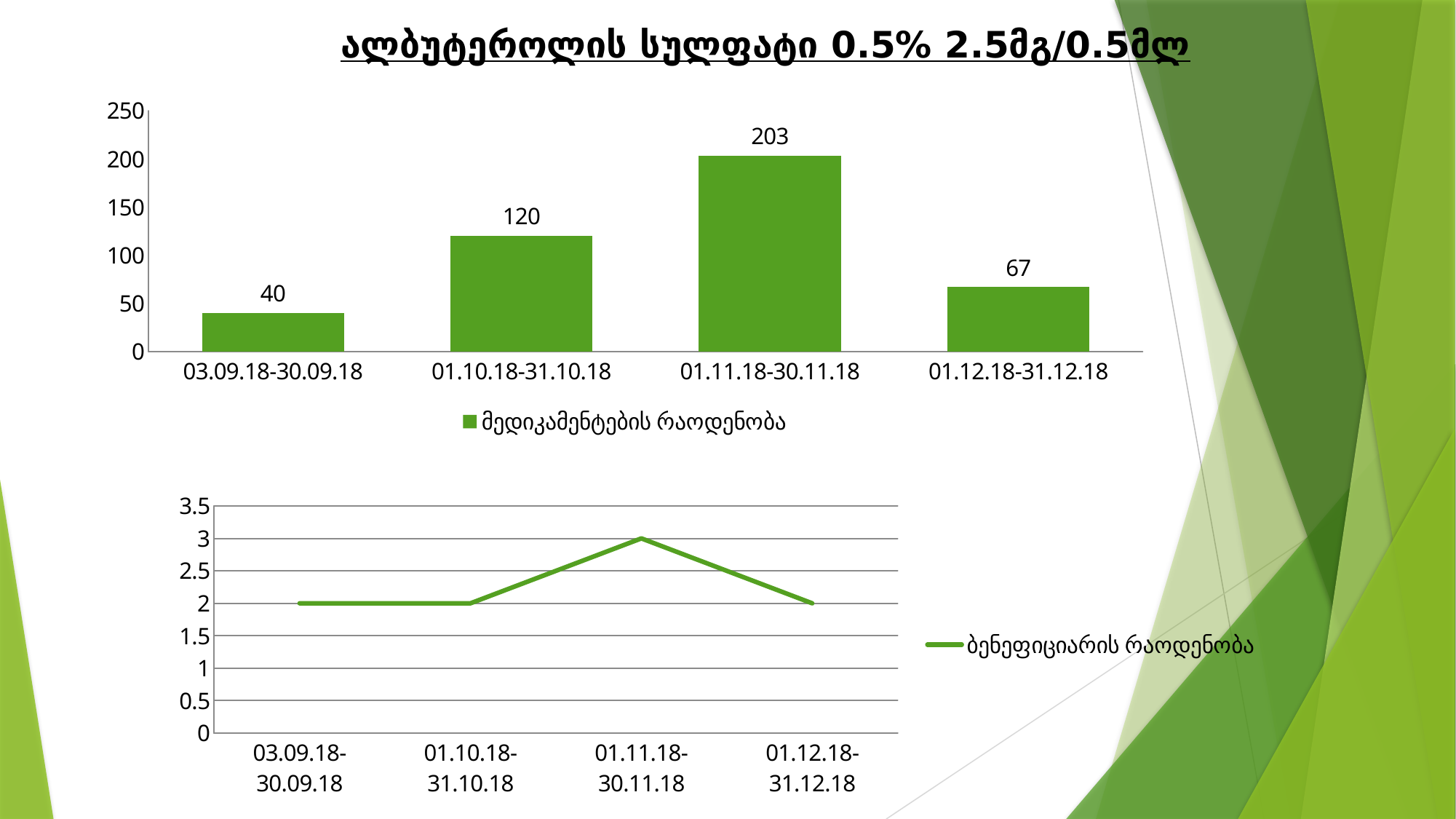
In the top bar chart, what is the difference between the values for 01.11.18-30.11.18 and 01.10.18-31.10.18? 83 In the top bar chart, which period has the lowest value? 03.09.18-30.09.18 In the bottom line chart, which period has the highest value? 01.11.18-30.11.18 In the bottom line chart, what is the value for 01.11.18-30.11.18? 3 How many series does the legend of the bottom line chart list? 1 What kind of chart is the top chart on the slide? bar chart In the top bar chart, which is larger: the value for 01.10.18-31.10.18 or for 01.12.18-31.12.18? 01.10.18-31.10.18 In the top bar chart, what is the value for 03.09.18-30.09.18? 40 How many periods are shown on the x axis of the top bar chart? 4 What kind of chart is the bottom chart on the slide? line chart In the top bar chart, which period has the highest value? 01.11.18-30.11.18 In the top bar chart, what is the value for 01.11.18-30.11.18? 203